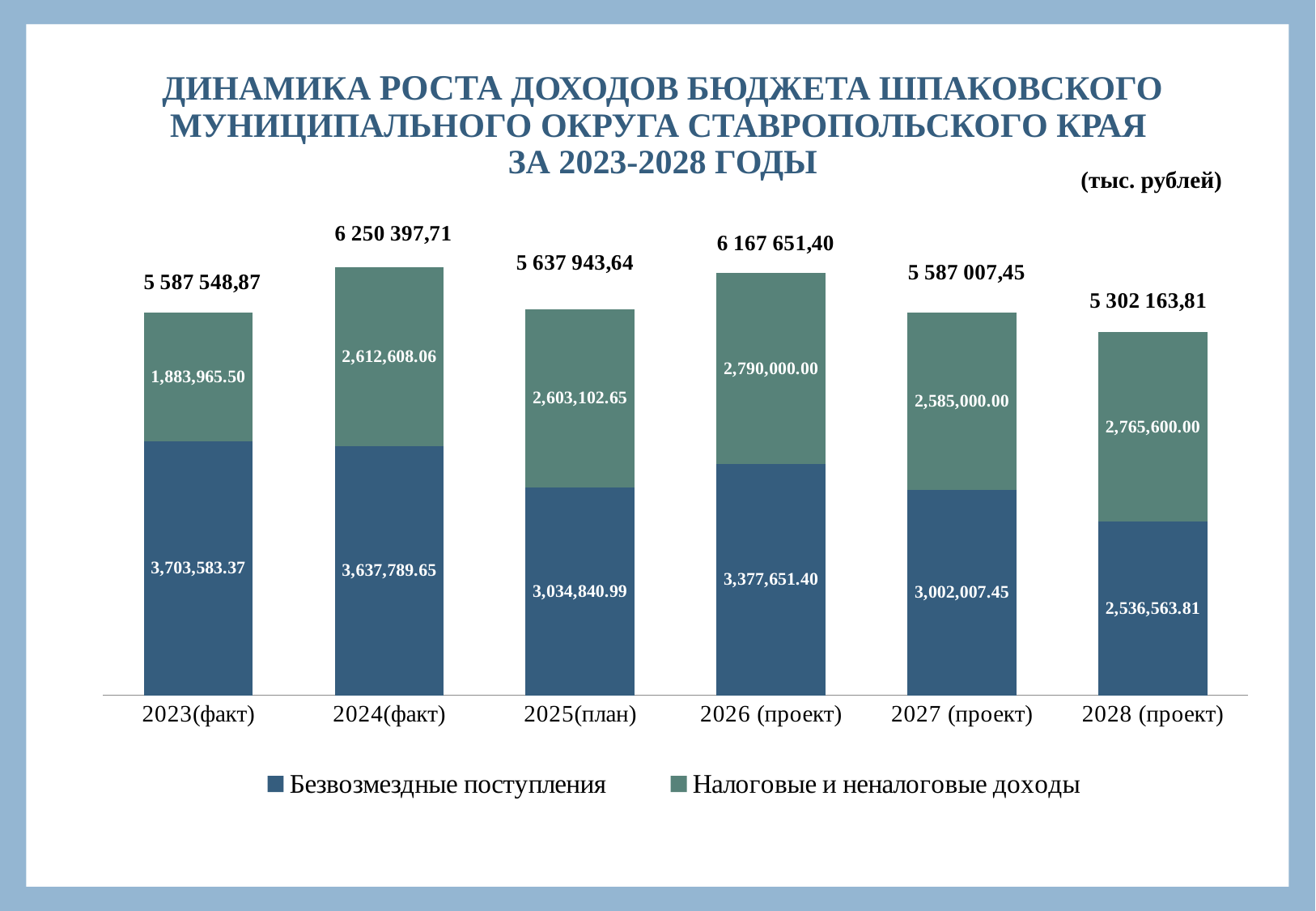
Which year has the lowest total budget income? 2028 (проект) Which year has the highest total budget income? 2024(факт) What is the value of Налоговые и неналоговые доходы for 2026 (проект)? 2,790,000.00 In 2028 (проект), which is larger: Безвозмездные поступления or Налоговые и неналоговые доходы? Налоговые и неналоговые доходы What type of chart is shown on the slide? Stacked bar chart What is the difference between Безвозмездные поступления and Налоговые и неналоговые доходы in 2026 (проект)? 587,651.40 Which year has the lowest value of Безвозмездные поступления? 2028 (проект) In what units are the values on the chart given, according to the note at the top right? тыс. рублей What is the total printed above the bar for 2025(план)? 5 637 943,64 What is the value of Безвозмездные поступления for 2023(факт)? 3,703,583.37 How many categories (years) are shown on the x axis? 6 How many series does the legend list? 2